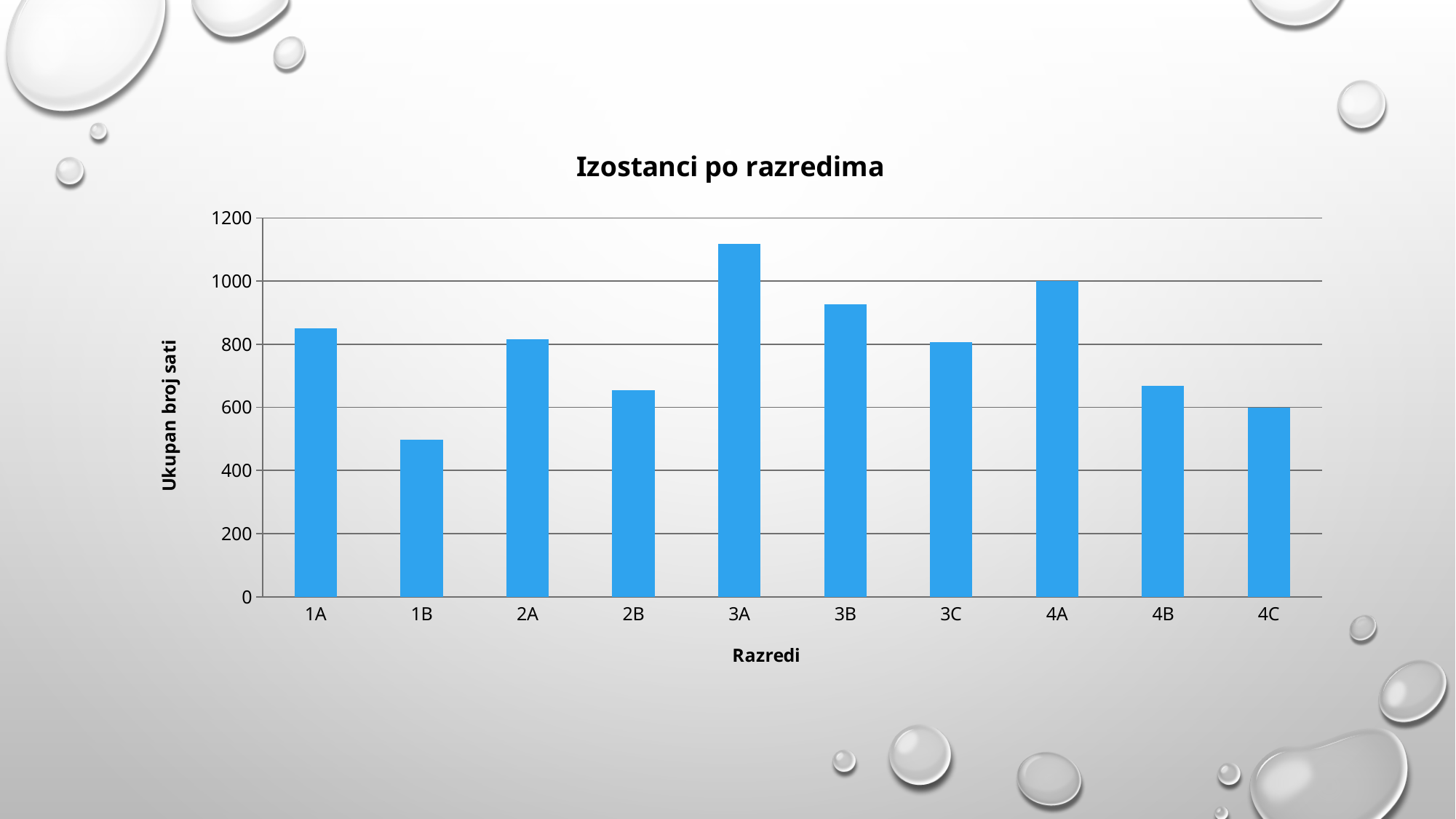
Is the value for 1A greater or less than 800? greater What is the label of the y axis? Ukupan broj sati Is the value for 4B greater or less than 800? less What is the title of the chart? Izostanci po razredima Is the value for 3A greater or less than 1000? greater Which class has the lowest total number of absence hours? 1B What type of chart is shown on the slide? bar chart How many classes (categories) are shown on the x axis? 10 Which class has the highest total number of absence hours? 3A Which has a higher value, 3B or 3C? 3B